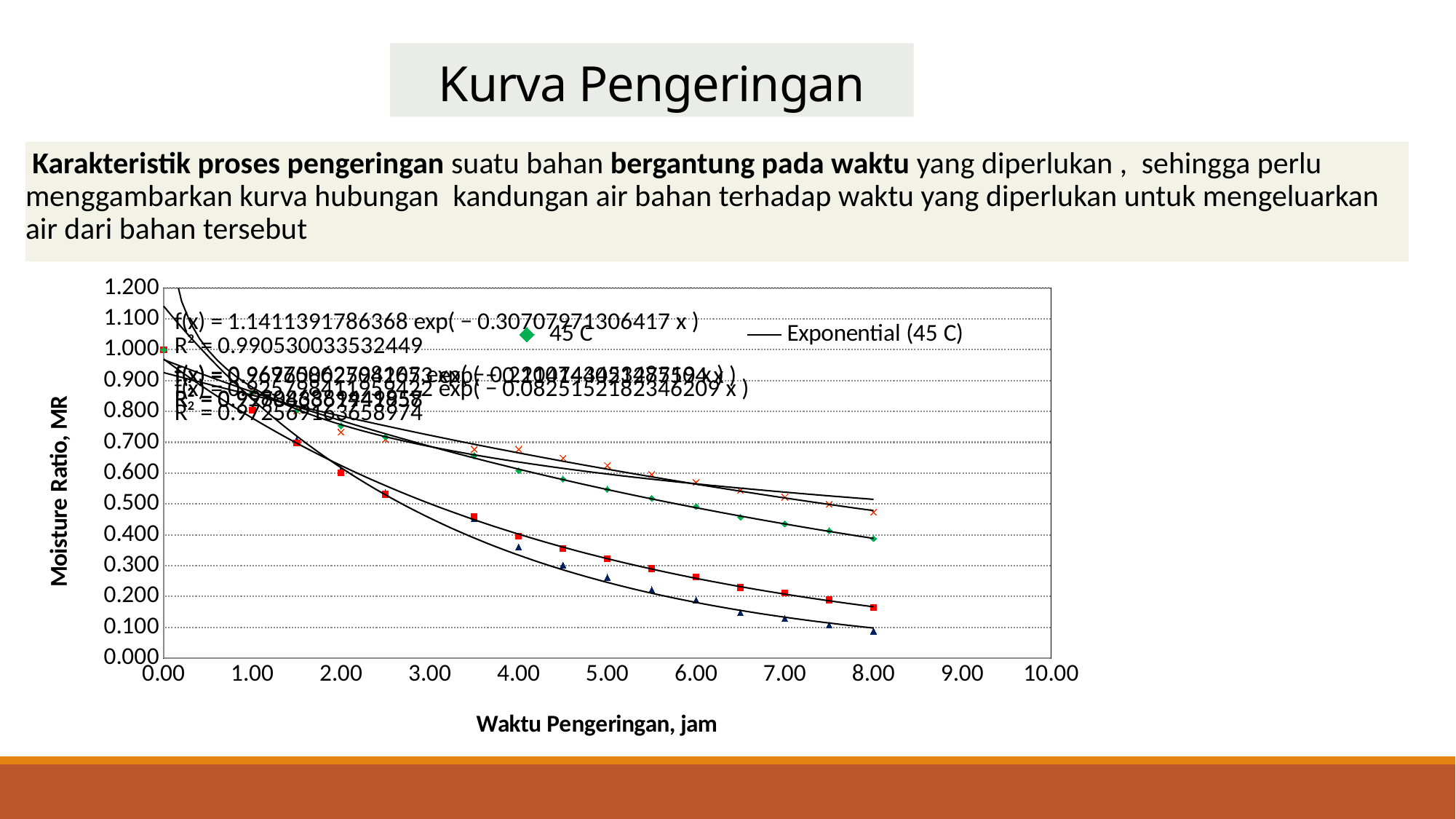
What kind of chart is shown on the slide? scatter chart What is the R² value shown for the first (topmost) exponential fit equation, f(x) = 1.1411391786368 exp(−0.30707971306417 x)? 0.990530033532449 What is the highest tick value shown on the y axis? 1.200 What is the moisture ratio of the 45 C series at time 0.00? 1.000 Is the moisture ratio of the red square series at 8.00 hours greater or less than 0.200? less What is the pre-exponential coefficient in the topmost fit equation on the chart? 1.1411391786368 Is the moisture ratio of the blue triangle series at 6.00 hours greater or less than 0.300? less What is the title of the x axis of the chart? Waktu Pengeringan, jam Do the moisture ratio values rise or fall as drying time increases along the x axis? fall Is the moisture ratio of the 45 C series (green diamonds) at 4.00 hours greater or less than 0.500? greater What is the title of the y axis of the chart? Moisture Ratio, MR